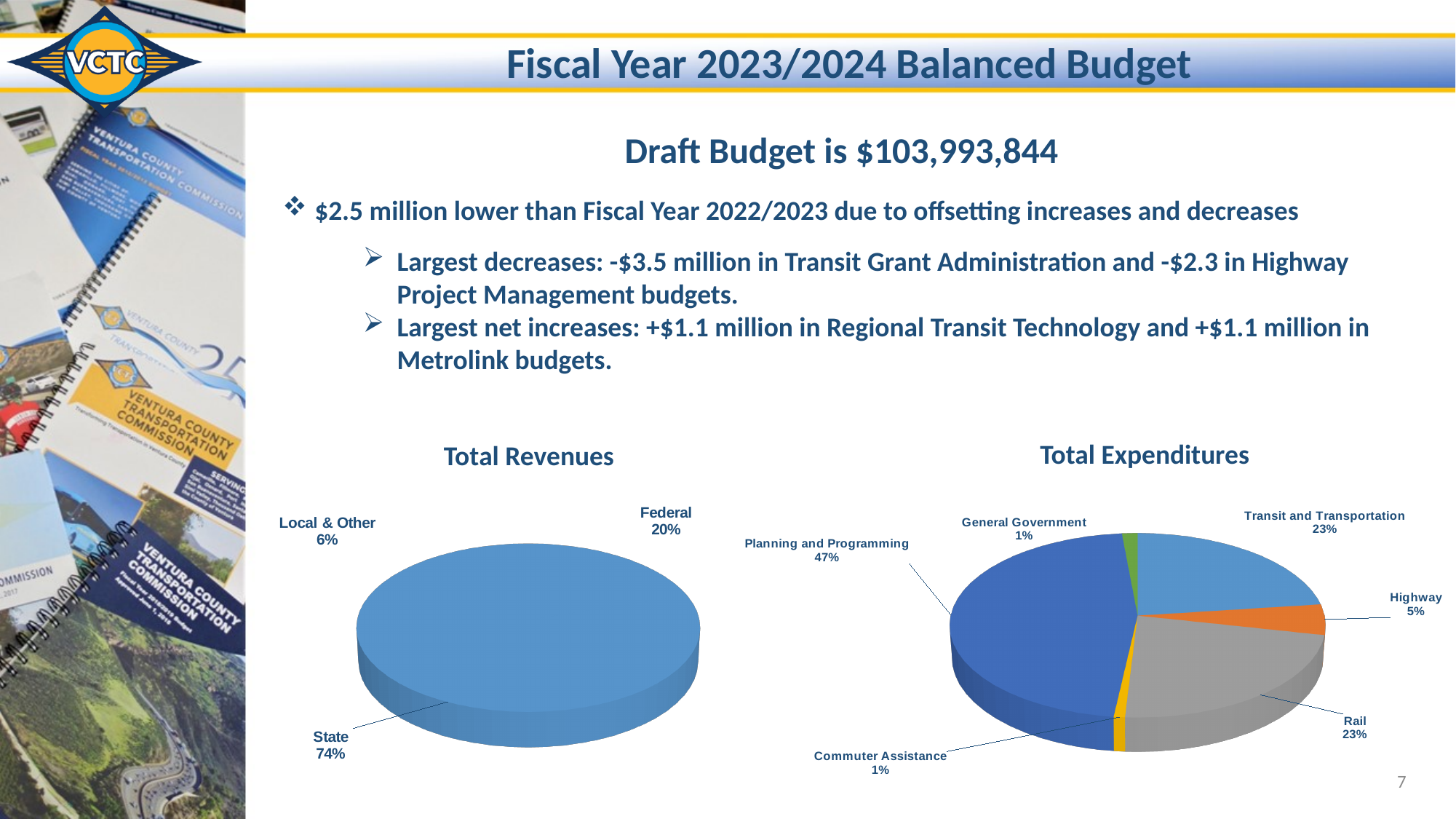
In the Total Revenues chart, what share of revenues comes from State? 74% In the Total Revenues chart, what percentage is labelled for Federal? 20% In the Total Revenues chart, how many categories are shown? 3 In the Total Revenues chart, what is the difference in percentage points between State and Federal? 54 In the Total Expenditures chart, how many categories are shown? 6 What type of chart is used for Total Expenditures? Pie chart In the Total Expenditures chart, which category has the largest share? Planning and Programming In the Total Expenditures chart, what is the difference in percentage points between Planning and Programming and Transit and Transportation? 24 In the Total Revenues chart, which category has the smallest share? Local & Other In the Total Expenditures chart, what percentage is labelled for Highway? 5% In the Total Expenditures chart, what share is Planning and Programming? 47% In the Total Expenditures chart, which is larger, Highway or Rail? Rail